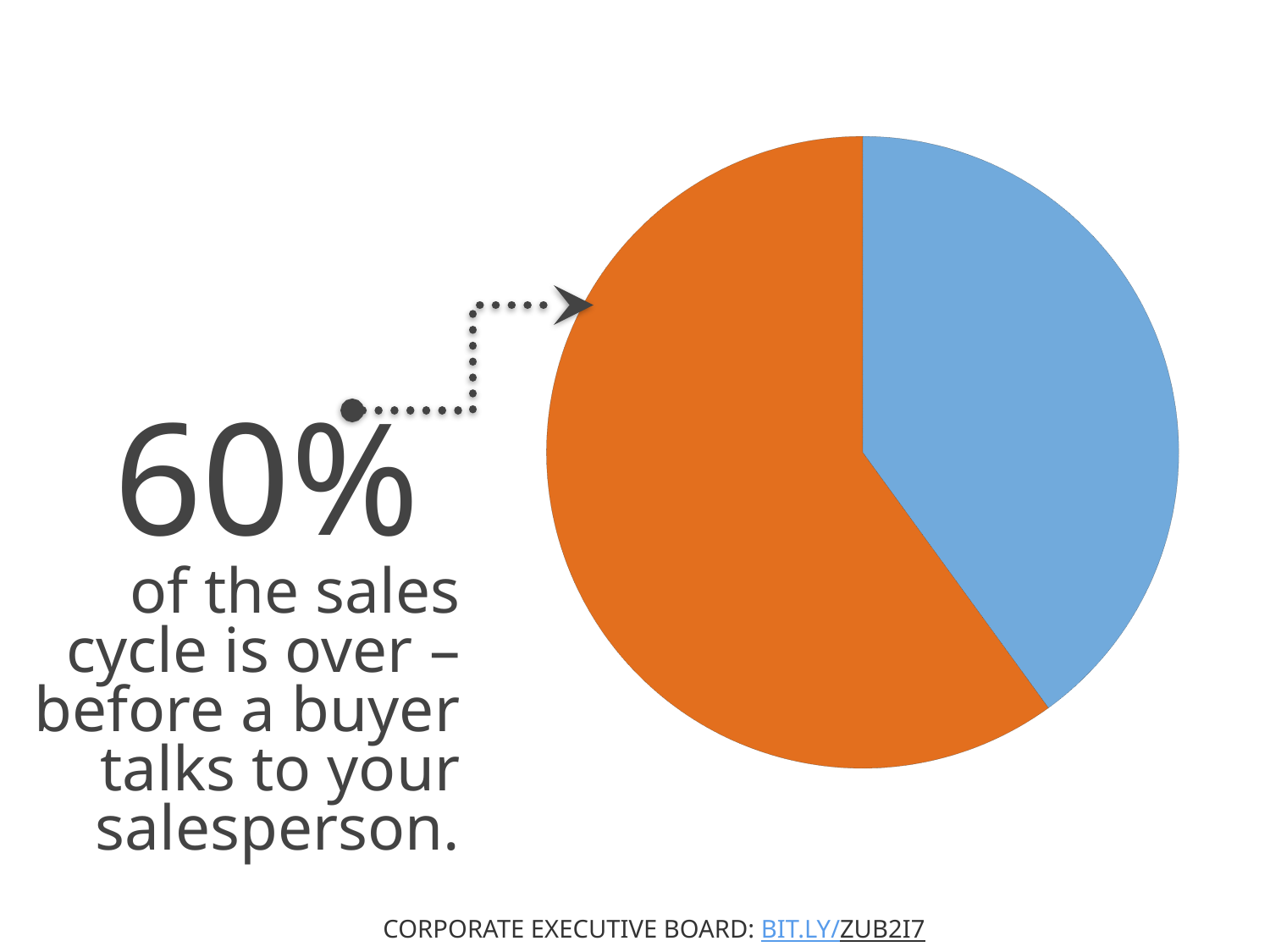
What does the 60% figure on the slide describe? of the sales cycle is over – before a buyer talks to your salesperson. What share of the pie does the orange slice represent, according to the figure printed on the slide? 60% How many slices does the pie chart have? 2 Is the blue slice more or less than half of the pie? less What kind of chart is shown on the slide? pie chart Which slice of the pie chart is the largest? the orange slice Which slice of the pie chart is the smallest? the blue slice Which slice is larger, the orange slice or the blue slice? the orange slice What colour is the slice that the dotted arrow from the 60% figure points to? orange